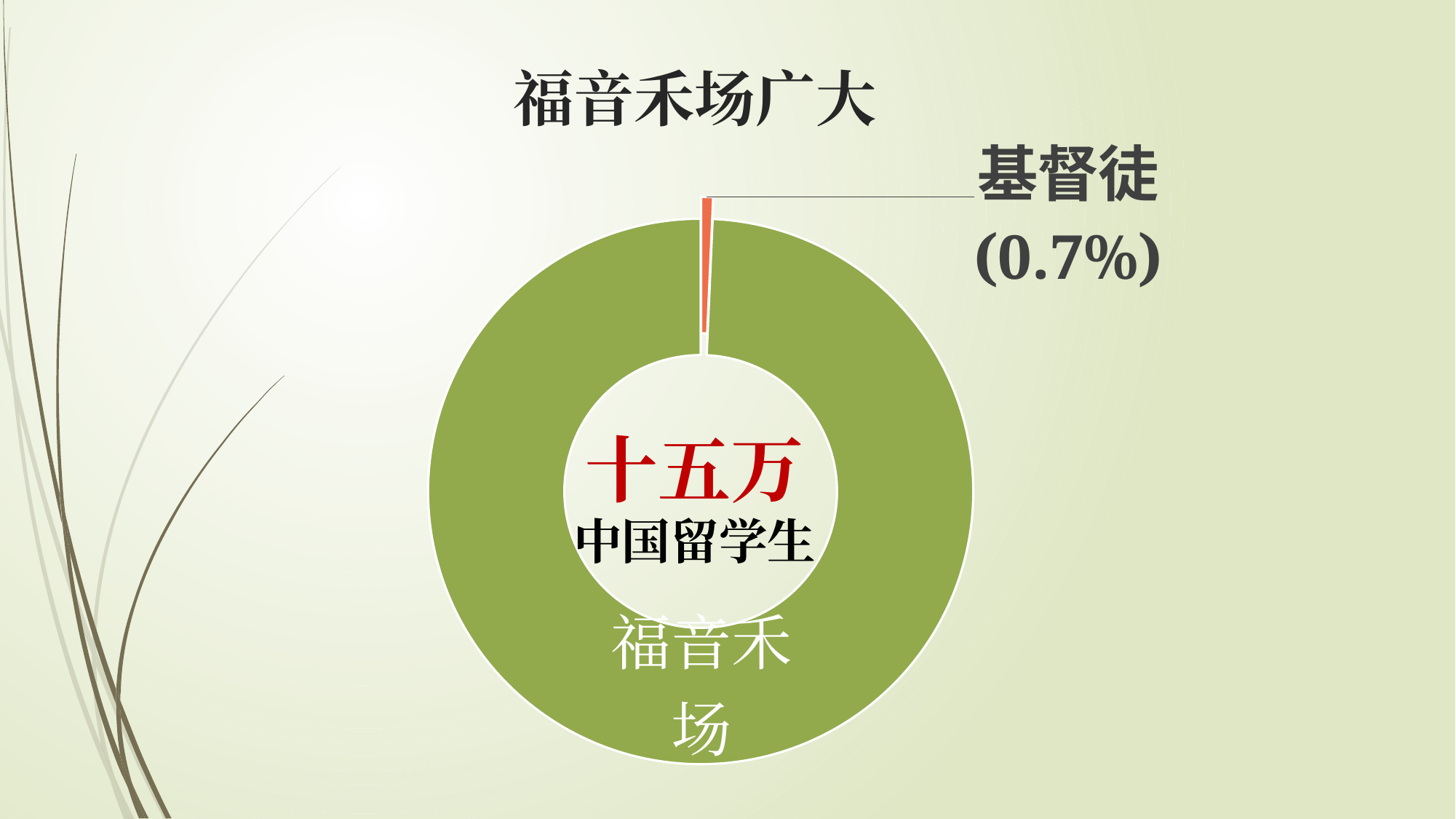
Which slice is the smallest in the chart? 基督徒 Which slice is the largest in the chart? 福音禾场 What share of the chart does the 基督徒 slice represent? 0.7% What group does the centre text of the chart say the 十五万 refers to? 中国留学生 What colour is the 基督徒 slice? Orange Which slice is larger, 基督徒 or 福音禾场? 福音禾场 What number is written in the centre of the doughnut chart? 十五万 What is the title of the chart? 福音禾场广大 What kind of chart is shown on the slide? Doughnut (pie) chart How many slices does the chart have? 2